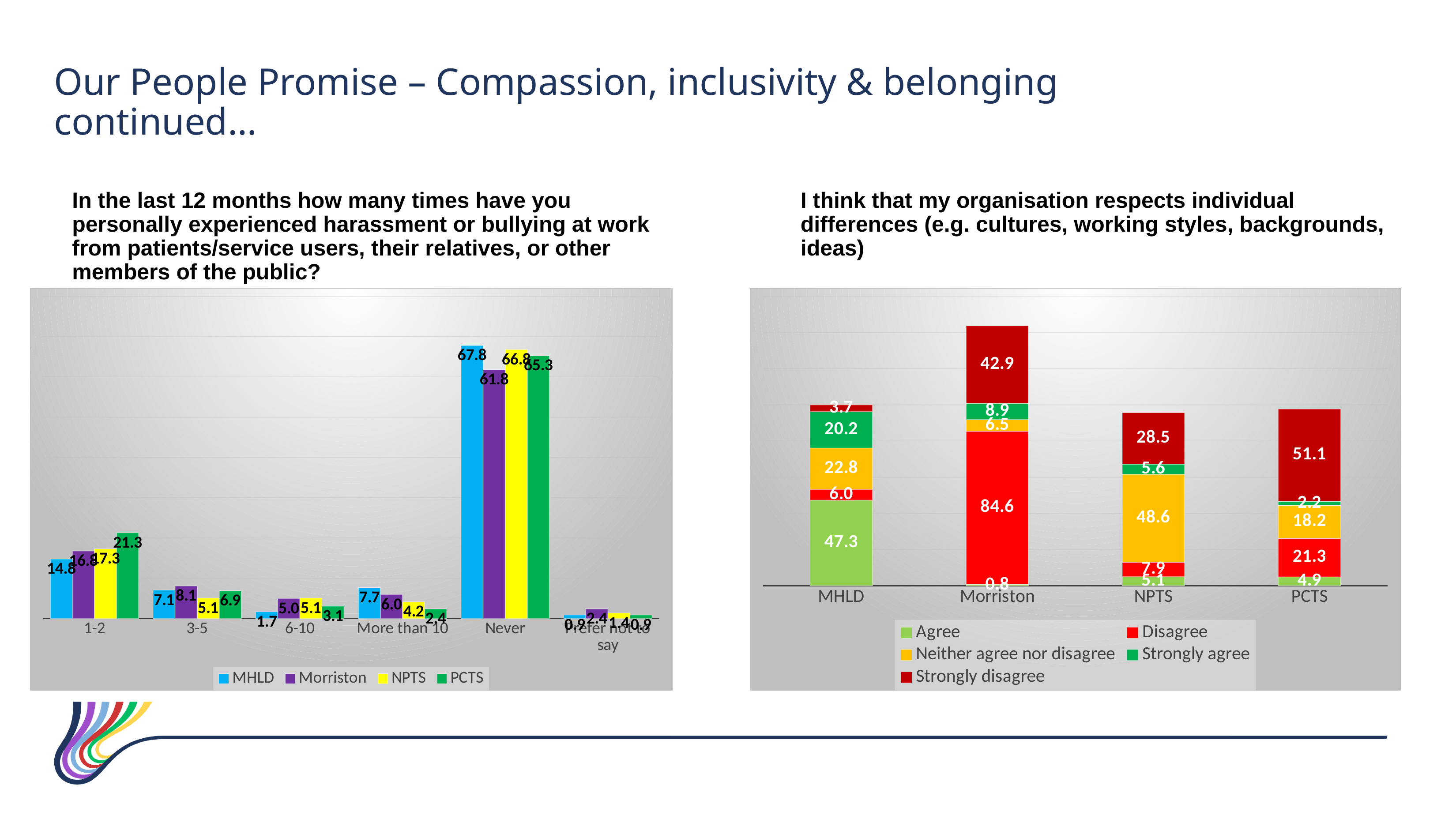
In the left chart on harassment or bullying from patients/service users, what is the difference between the MHLD and Morriston values in the 'Never' category? 6.0 In the right chart on whether the organisation respects individual differences, what is the 'Strongly disagree' value for PCTS? 51.1 In the right chart on whether the organisation respects individual differences, which colour represents 'Strongly disagree' in the legend? Dark red In the left chart on harassment or bullying from patients/service users, how many series does the legend list? 4 In the left chart on harassment or bullying from patients/service users, which is larger in the '6-10' category: MHLD or Morriston? Morriston In the left chart on harassment or bullying from patients/service users, what is the value for PCTS in the '1-2' category? 21.3 In the right chart on whether the organisation respects individual differences, what is the total of the stacked bar for MHLD? 100.0 In the right chart on whether the organisation respects individual differences, what kind of chart is shown? Stacked bar chart In the left chart on harassment or bullying from patients/service users, which series has the lowest value in the 'Never' category? Morriston In the left chart on harassment or bullying from patients/service users, how many categories are shown on the x axis? 6 In the left chart on harassment or bullying from patients/service users, what is the value for MHLD in the 'Never' category? 67.8 In the right chart on whether the organisation respects individual differences, what is the 'Neither agree nor disagree' value for NPTS? 48.6